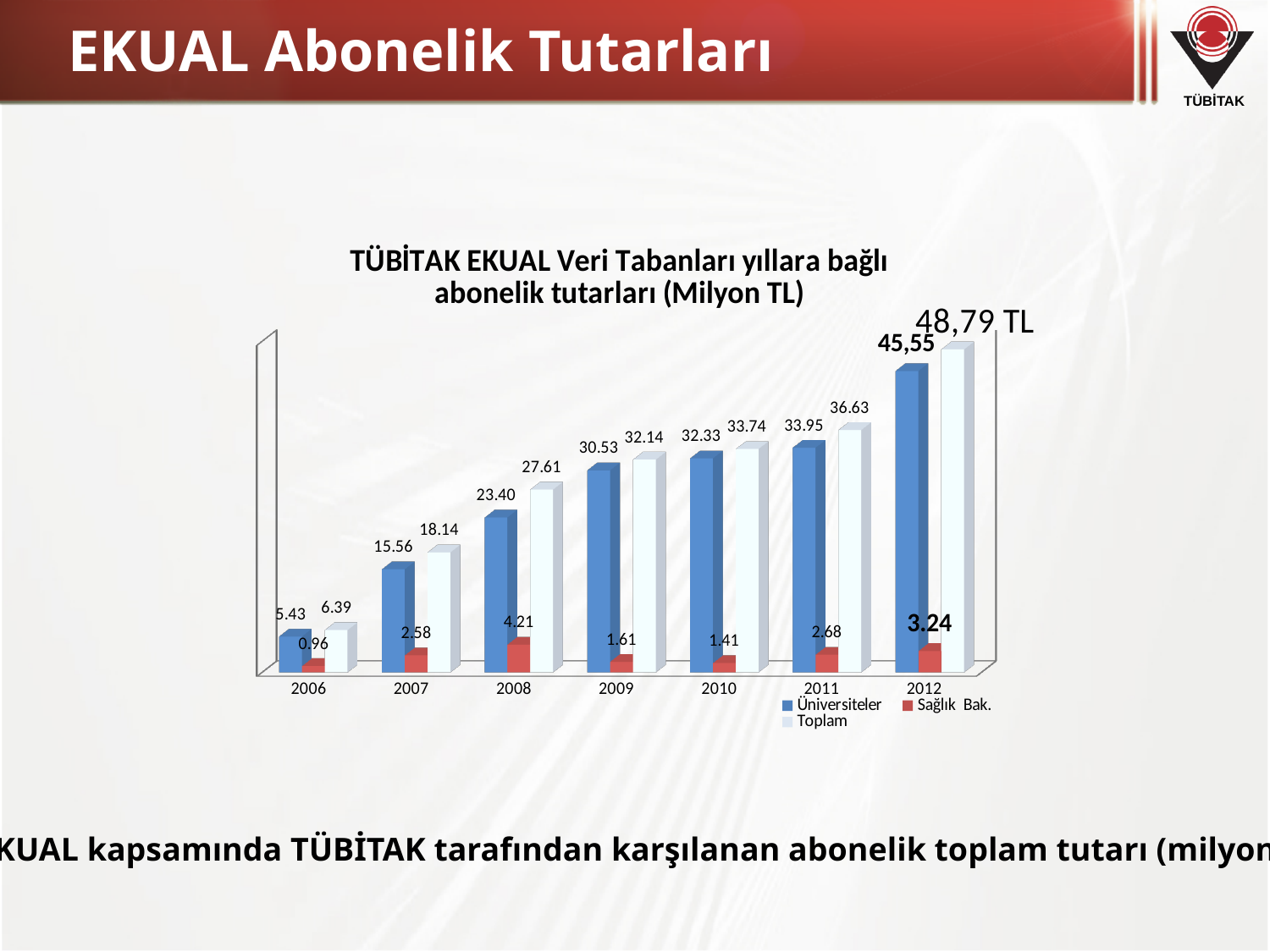
What is the Toplam value for 2011? 36.63 What kind of chart is shown on the slide? Bar chart How many series does the legend list? 3 Which year has the lowest Toplam value? 2006 What is the value for Üniversiteler in 2009? 30.53 Which is larger, the Sağlık Bak. value for 2007 or for 2011? 2011 What is the Üniversiteler value shown for 2012? 45,55 What is the difference between the Toplam values for 2008 and 2007? 9.47 Which year has the highest Sağlık Bak. value? 2008 Do the Üniversiteler values rise or fall from 2006 to 2012? Rise What is the value for Sağlık Bak. in 2008? 4.21 How many years are shown on the x axis? 7